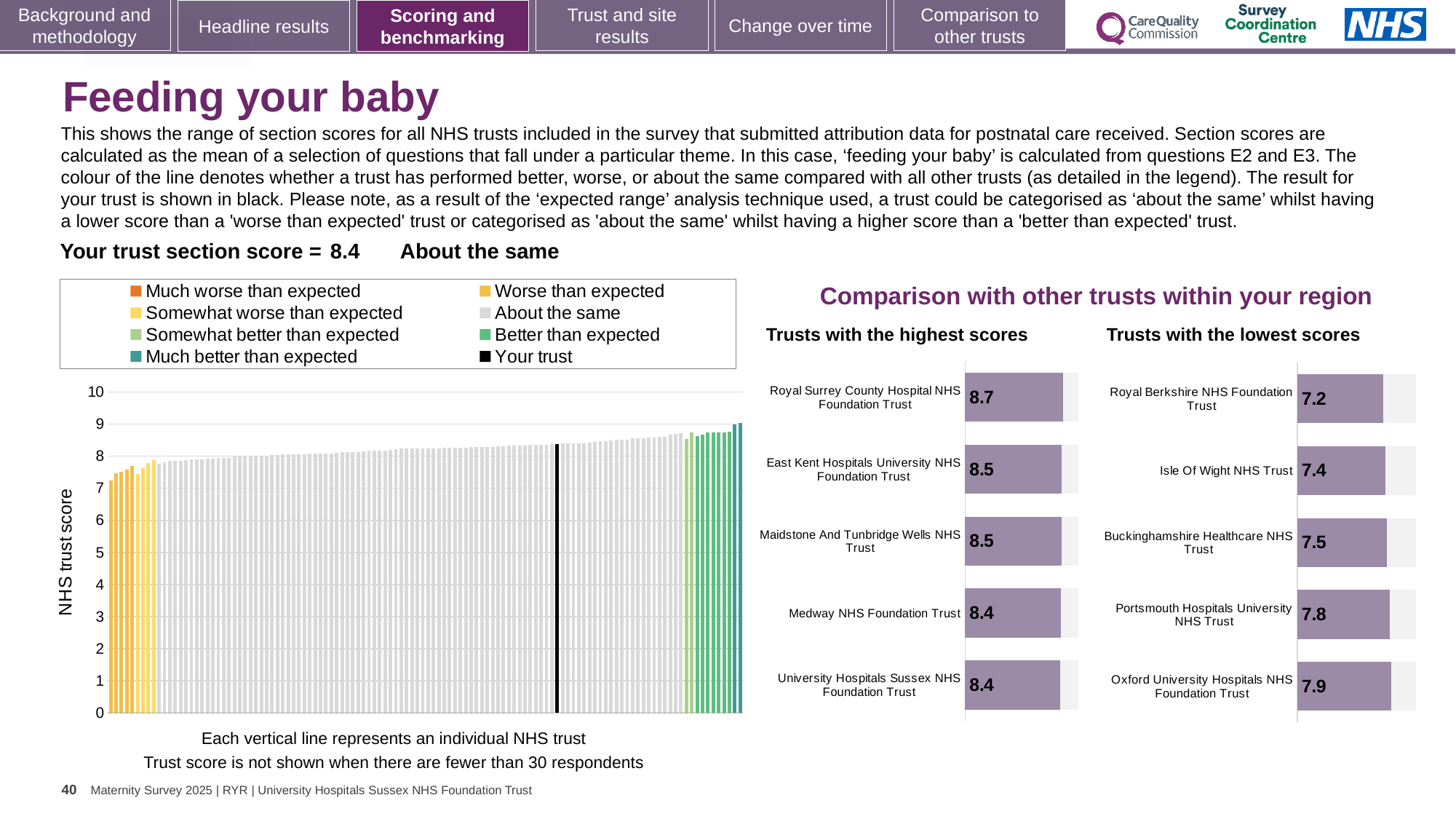
In the 'Trusts with the lowest scores' chart, what is the score for Isle Of Wight NHS Trust? 7.4 In the 'Trusts with the highest scores' chart, which trust has the highest score? Royal Surrey County Hospital NHS Foundation Trust In the 'Trusts with the highest scores' chart, what is the difference between the scores of Royal Surrey County Hospital NHS Foundation Trust and Medway NHS Foundation Trust? 0.3 How many entries does the legend above the large 'NHS trust score' chart list? 8 In the 'Trusts with the lowest scores' chart, how much higher is Oxford University Hospitals NHS Foundation Trust's score than Royal Berkshire NHS Foundation Trust's? 0.7 In the 'Trusts with the lowest scores' chart, which has the larger score: Buckinghamshire Healthcare NHS Trust or Portsmouth Hospitals University NHS Trust? Portsmouth Hospitals University NHS Trust What kind of chart is the large 'NHS trust score' chart on the left of the slide? Bar chart In the 'Trusts with the highest scores' chart, what is the score for Royal Surrey County Hospital NHS Foundation Trust? 8.7 In the 'Trusts with the lowest scores' chart, which trust has the lowest score? Royal Berkshire NHS Foundation Trust In the large 'NHS trust score' chart on the left, is the value of the leftmost bar greater or less than 8? less In the large 'NHS trust score' chart on the left, do the bar values rise or fall from left to right? Rise How many trusts are listed in the 'Trusts with the highest scores' chart? 5